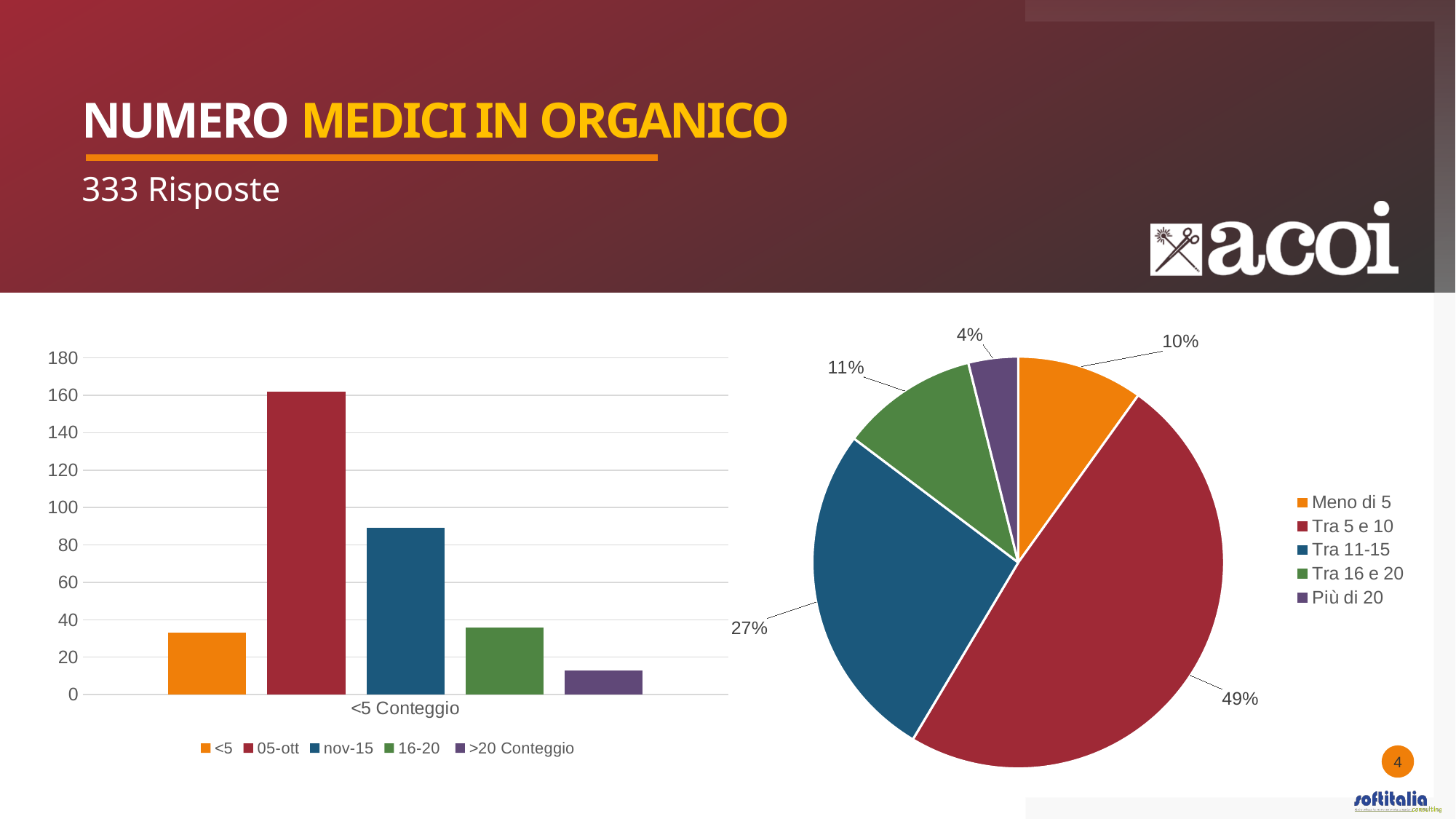
In the pie chart on the right, what share does the 'Tra 11-15' slice have? 27% What kind of chart is the chart on the right of the slide? pie chart In the pie chart on the right, what share does the 'Tra 5 e 10' slice have? 49% In the pie chart on the right, what is the difference in percentage points between the 'Tra 5 e 10' slice and the 'Tra 11-15' slice? 22 How many entries does the legend of the pie chart on the right list? 5 In the pie chart on the right, which category has the largest slice? Tra 5 e 10 What kind of chart is the chart on the left of the slide? bar chart In the bar chart on the left, is the value for '>20 Conteggio' greater or less than 20? less In the bar chart on the left, is the value for '05-ott' greater or less than 140? greater In the pie chart on the right, which category has the smallest slice? Più di 20 In the bar chart on the left, which series has the tallest bar? 05-ott In the pie chart on the right, what share does the 'Più di 20' slice have? 4%